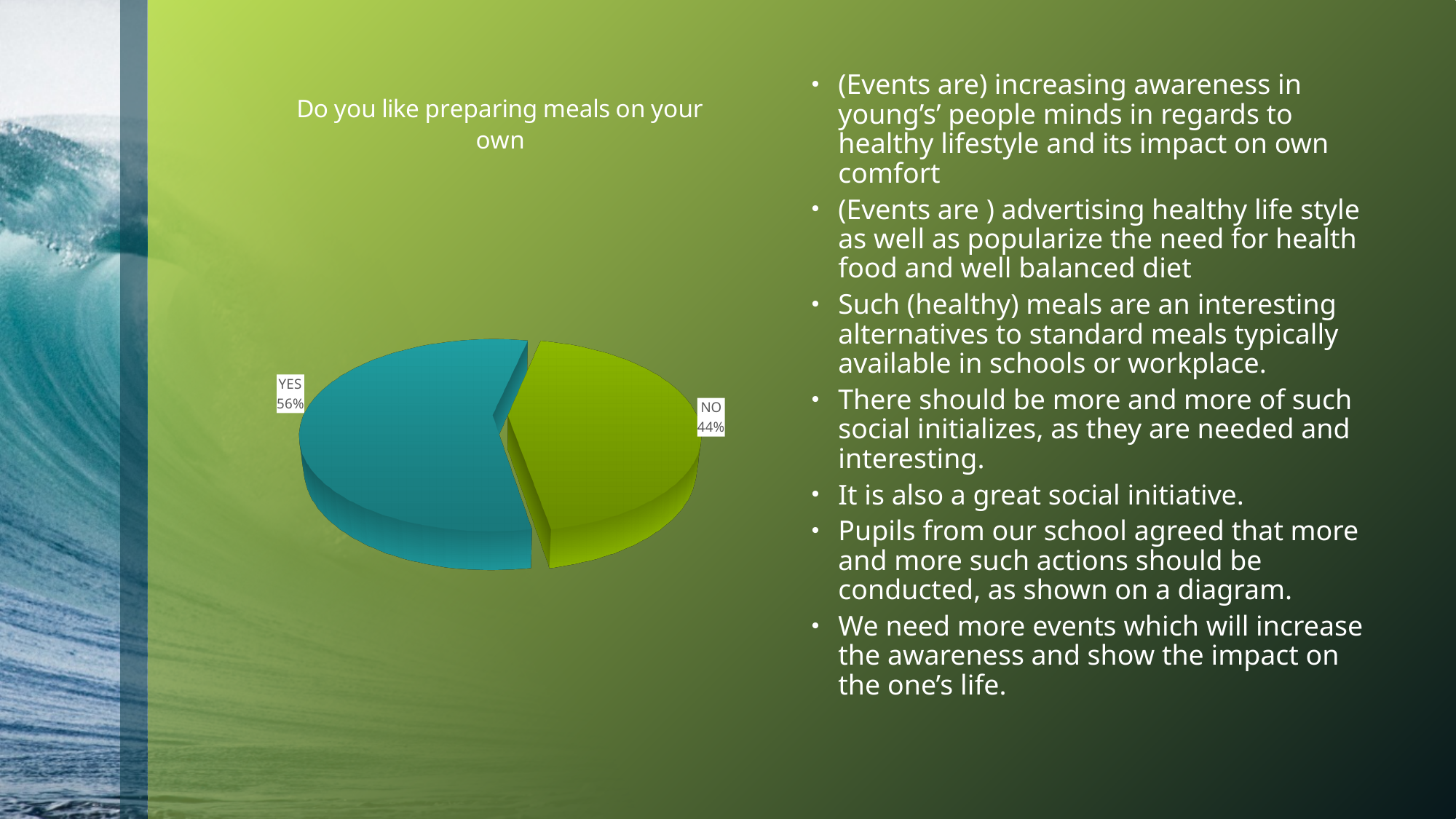
What type of chart is shown on the slide? Pie chart Which response has the smaller share of the pie? NO What colour is the YES slice? Blue (teal) What share of the pie does the NO slice represent? 44% How many slices does the pie chart have? 2 What is the difference in percentage points between the YES and NO shares? 12 Which is larger, the YES share or the NO share? YES Which response has the larger share of the pie? YES What is the title of the chart? Do you like preparing meals on your own What percentage of respondents answered YES? 56% What percentage of respondents answered NO? 44%